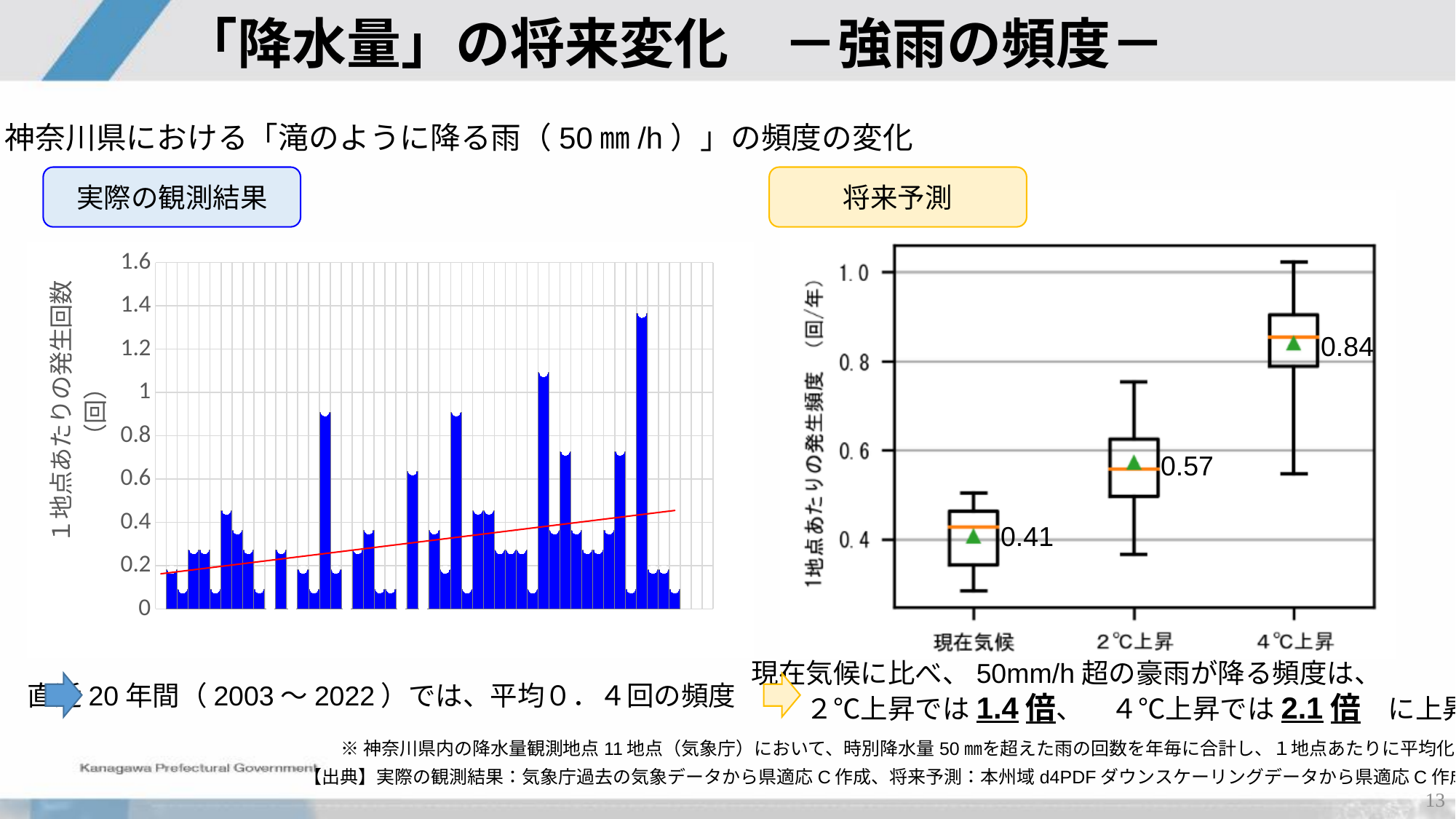
In the right chart (将来予測), what is the labelled value for 現在気候? 0.41 In the right chart (将来予測), which category has the lowest labelled value? 現在気候 In the right chart (将来予測), which category has the highest labelled value? 4℃上昇 In the left chart (実際の観測結果), is the tallest bar greater or less than 1.2? greater In the right chart (将来予測), do the labelled values rise or fall from 現在気候 to 4℃上昇? rise In the right chart (将来予測), what is the difference between the labelled values for 4℃上昇 and 現在気候? 0.43 In the right chart (将来予測), which is larger, the labelled value for 2℃上昇 or for 現在気候? 2℃上昇 How many categories are shown on the x axis of the right chart (将来予測)? 3 In the right chart (将来予測), what is the labelled value for 2℃上昇? 0.57 In the right chart (将来予測), what is the labelled value for 4℃上昇? 0.84 What kind of chart is the left chart (実際の観測結果)? bar chart In the right chart (将来予測), what is the difference between the labelled values for 4℃上昇 and 2℃上昇? 0.27